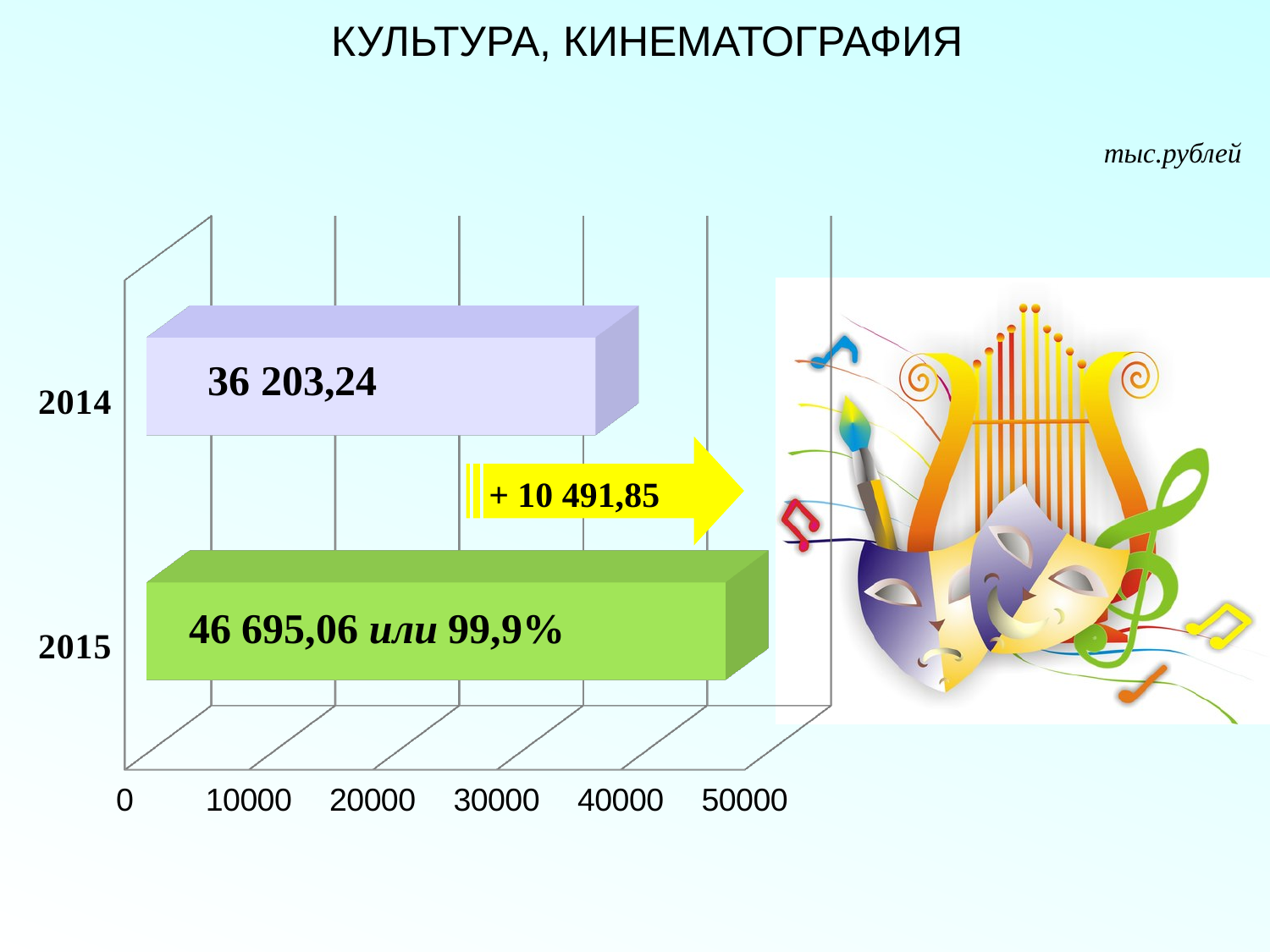
How many bars are shown in the chart? 2 What unit is indicated for the chart values? тыс.рублей What is the value for 2014? 36 203,24 What is the difference between the 2015 and 2014 values? 10 491,85 What is the value for 2015? 46 695,06 Which year has the lower value? 2014 What percentage is shown next to the 2015 value? 99,9% What kind of chart is shown on the slide? Bar chart Is the value for 2015 larger than the value for 2014? Yes Is the value for 2015 greater or less than 40000? greater Which year has the higher value? 2015 Is the value for 2014 greater or less than 40000? less